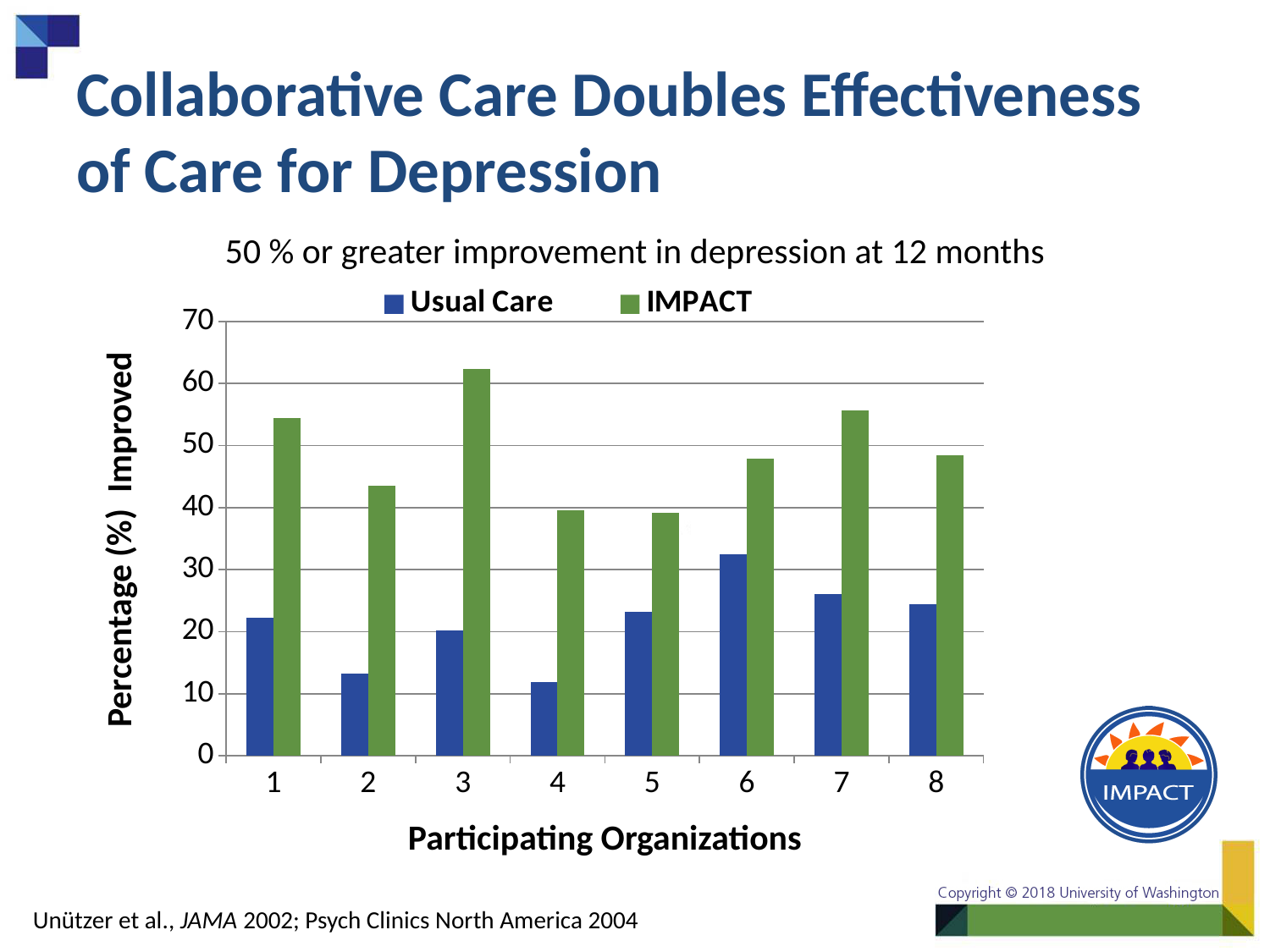
Is the IMPACT value for organization 3 greater or less than 60? greater Which participating organization has the highest IMPACT value? 3 How many participating organizations are shown on the x axis? 8 Which participating organization has the highest Usual Care value? 6 Is the Usual Care value for organization 2 greater or less than 20? less What kind of chart is shown on the slide? bar chart For organization 1, which is larger: the Usual Care value or the IMPACT value? IMPACT How many series does the chart legend list? 2 What are the two series named in the chart legend? Usual Care and IMPACT Is the Usual Care value for organization 6 greater or less than 30? greater Which is larger: the Usual Care value for organization 6 or for organization 2? organization 6